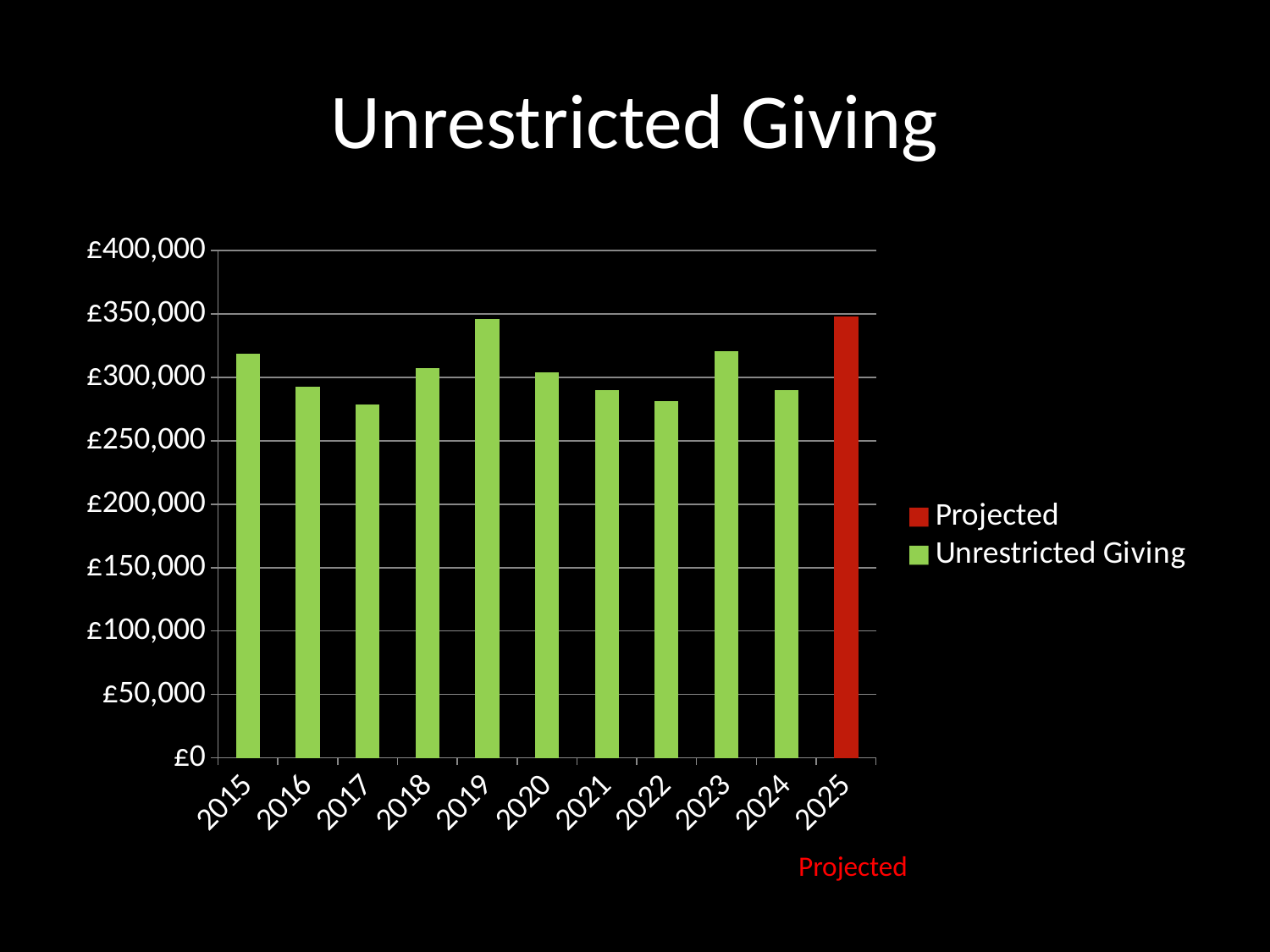
Is the value for 2025 greater or less than £300,000? greater Is the value for 2017 greater or less than £300,000? less Which is larger, the value for 2023 or the value for 2024? 2023 Which year's bar is shown in red as Projected? 2025 Is the value for 2019 greater or less than £300,000? greater How many years are shown on the x axis? 11 What is the title of the chart? Unrestricted Giving Which is larger, the value for 2019 or the value for 2020? 2019 What kind of chart is shown on the slide? bar chart How many series does the legend list? 2 Which is larger, the value for 2015 or the value for 2016? 2015